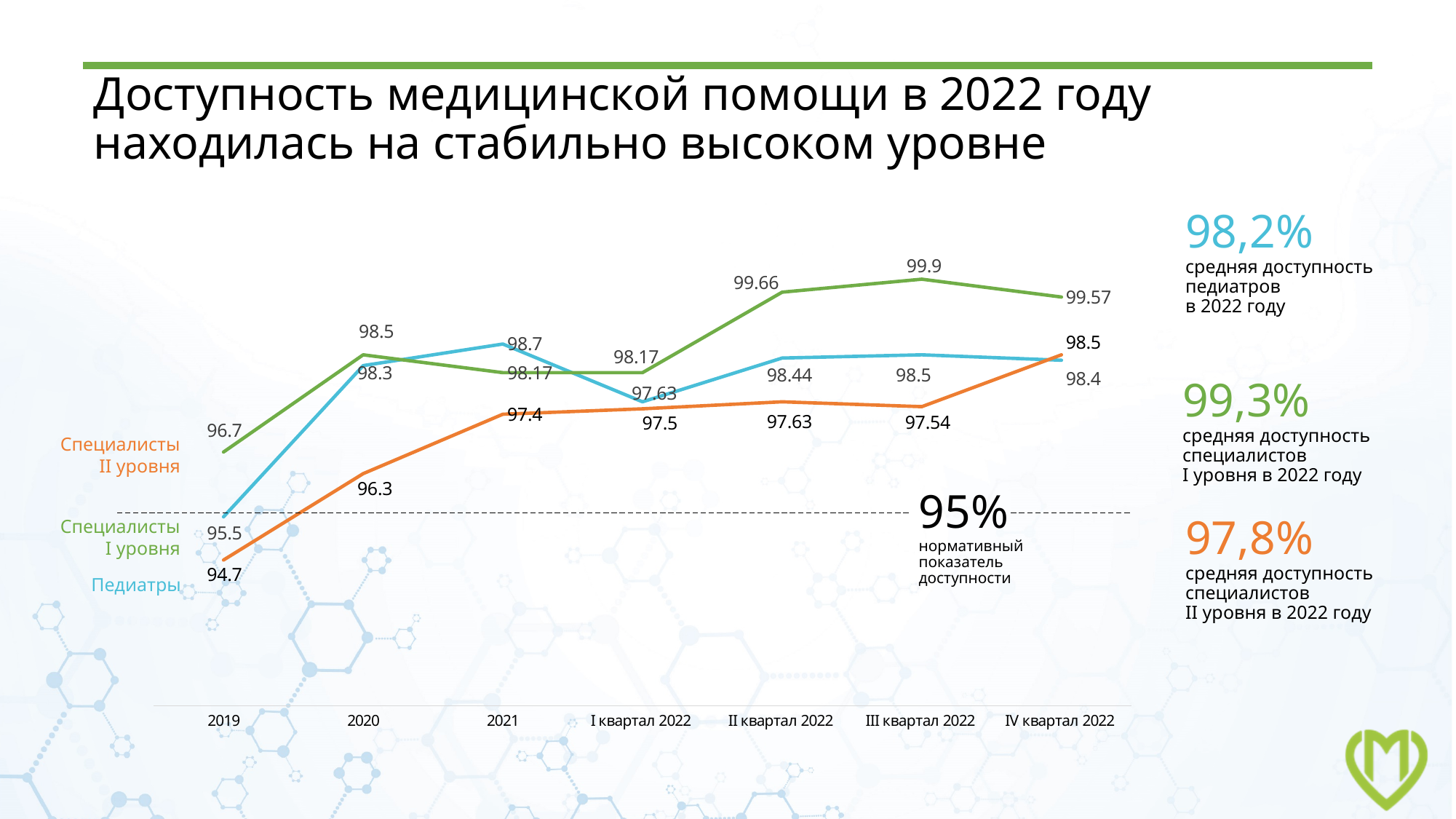
Does the Специалисты II уровня series rise or fall from 2019 to 2021? rise What is the value for Педиатры in 2019? 95.5 In which period does the Специалисты I уровня series reach its highest value? III квартал 2022 What type of chart is shown on the slide? line chart What is the value for Специалисты II уровня in IV квартал 2022? 98.5 What value does the dashed horizontal line on the chart mark as the normative accessibility indicator? 95% How many series are plotted on the chart? 3 What is the value for Специалисты I уровня in III квартал 2022? 99.9 What is the difference between the Специалисты I уровня value and the Специалисты II уровня value in 2019? 2 Which is larger in 2021: the value for Педиатры or the value for Специалисты II уровня? Педиатры How many points are on the x axis of the chart? 7 In which period does the Специалисты II уровня series reach its lowest value? 2019